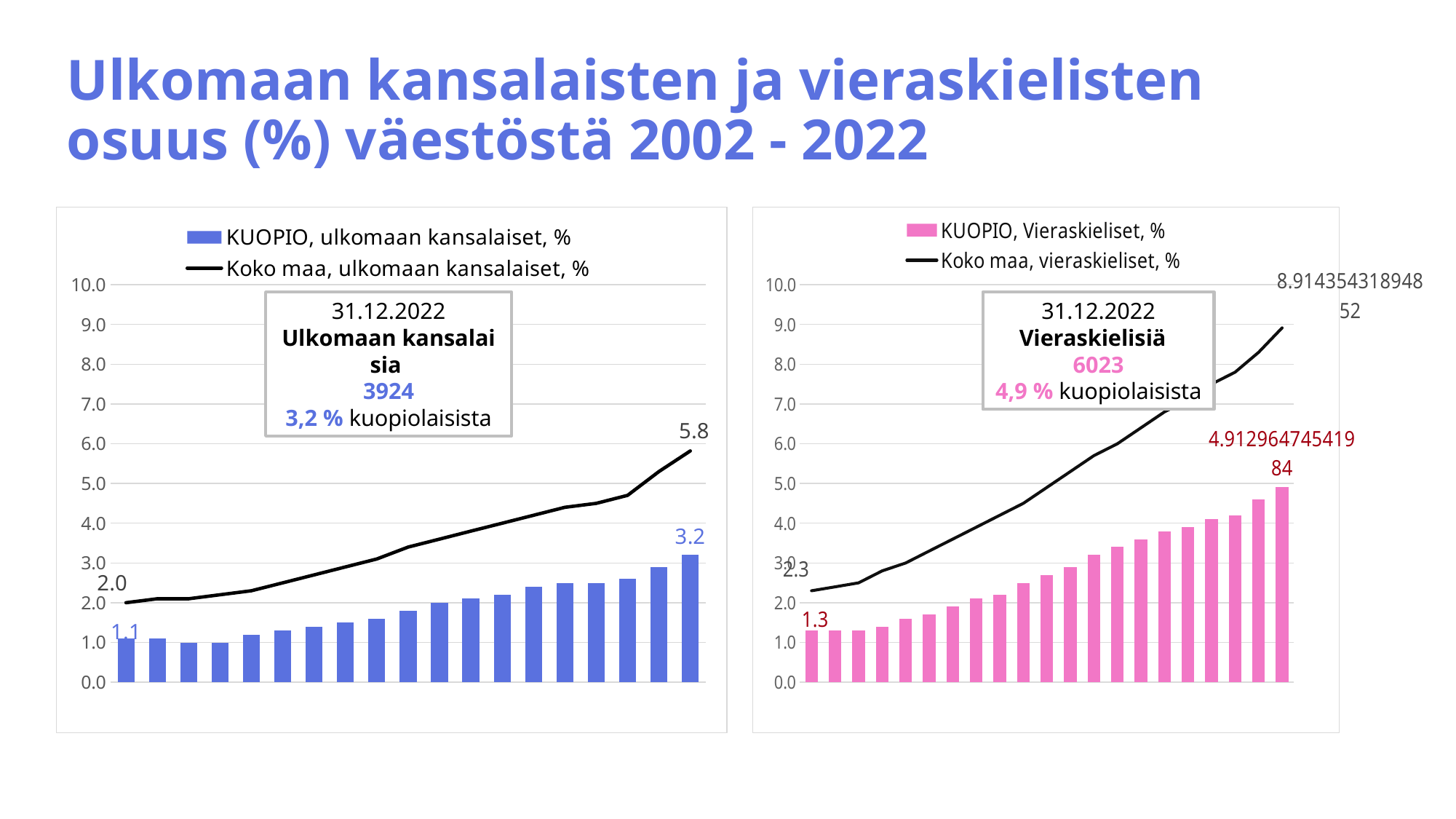
On the right chart, is the value of the last KUOPIO, Vieraskieliset, % bar greater or less than 4.0? greater On the left chart, what is the first labelled value of the Koko maa, ulkomaan kansalaiset, % line? 2.0 On the left chart, what is the final labelled value of the Koko maa, ulkomaan kansalaiset, % line? 5.8 On the right chart, at the final point, which is larger: the Koko maa, vieraskieliset, % line or the KUOPIO, Vieraskieliset, % bar? Koko maa, vieraskieliset, % line On the right chart, what is the data label on the first bar for KUOPIO, Vieraskieliset, %? 1.3 On the left chart, what is the data label on the first bar for KUOPIO, ulkomaan kansalaiset, %? 1.1 On the left chart, what is the difference between the final labelled values of the Koko maa line (5.8) and the KUOPIO bars (3.2)? 2.6 On the left chart, what is the difference between the last and first labelled values of the KUOPIO, ulkomaan kansalaiset, % bars? 2.1 How many series does the legend of the right chart list? 2 On the right chart, what is the first labelled value of the Koko maa, vieraskieliset, % line? 2.3 On the left chart, do the KUOPIO, ulkomaan kansalaiset, % bars generally rise or fall from left to right? rise On the left chart, what is the data label on the last bar for KUOPIO, ulkomaan kansalaiset, %? 3.2